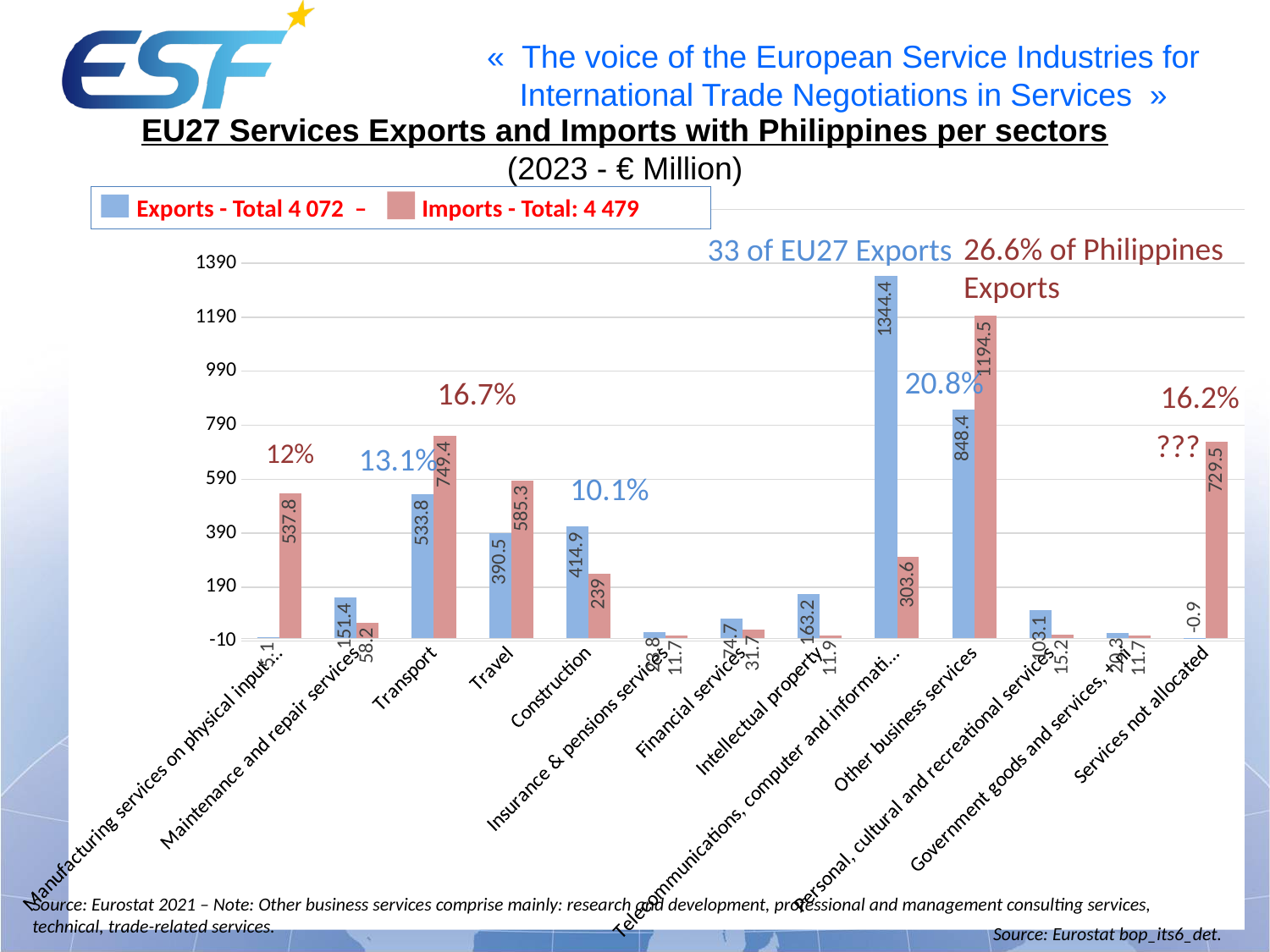
According to the legend, what is the total of EU27 exports? 4 072 Which sector has the highest exports value? Telecommunications, computer and information services What kind of chart is shown on the slide? bar chart What is the difference between imports and exports for Transport? 215.6 How many sector categories are plotted on the x axis? 13 What is the value of EU27 exports for Telecommunications, computer and information services? 1344.4 What is the value of EU27 imports for Travel? 585.3 Which sector has the highest imports value? Other business services What is the value of EU27 exports for Transport? 533.8 What is the value of EU27 imports for Services not allocated? 729.5 How many series does the legend list? 2 For Construction, which is larger: exports or imports? Exports